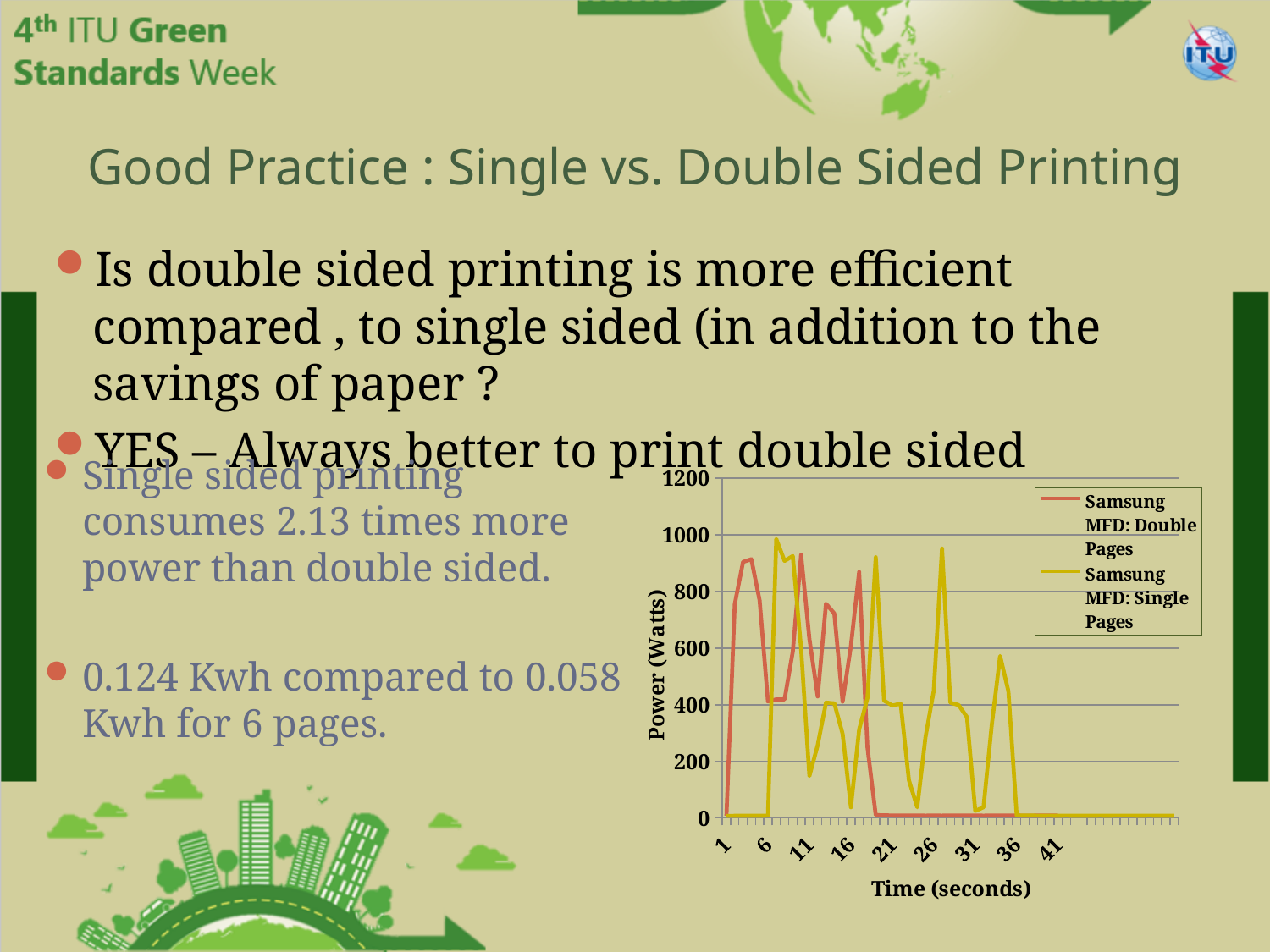
How many series does the chart legend list? 2 Is the peak value of the Samsung MFD: Single Pages series greater or less than 800? greater Is the value of the Samsung MFD: Single Pages series at time 41 greater or less than 200? less What kind of chart is shown on the slide? line chart Is the peak value of the Samsung MFD: Double Pages series greater or less than 800? greater What is the title of the chart's x axis? Time (seconds) What is the title of the chart's y axis? Power (Watts) Does the Samsung MFD: Double Pages series rise or fall between time 16 and time 21? fall How many labelled tick marks are shown on the x axis? 9 Which series drops to zero and stays there earlier along the time axis, Samsung MFD: Double Pages or Samsung MFD: Single Pages? Samsung MFD: Double Pages